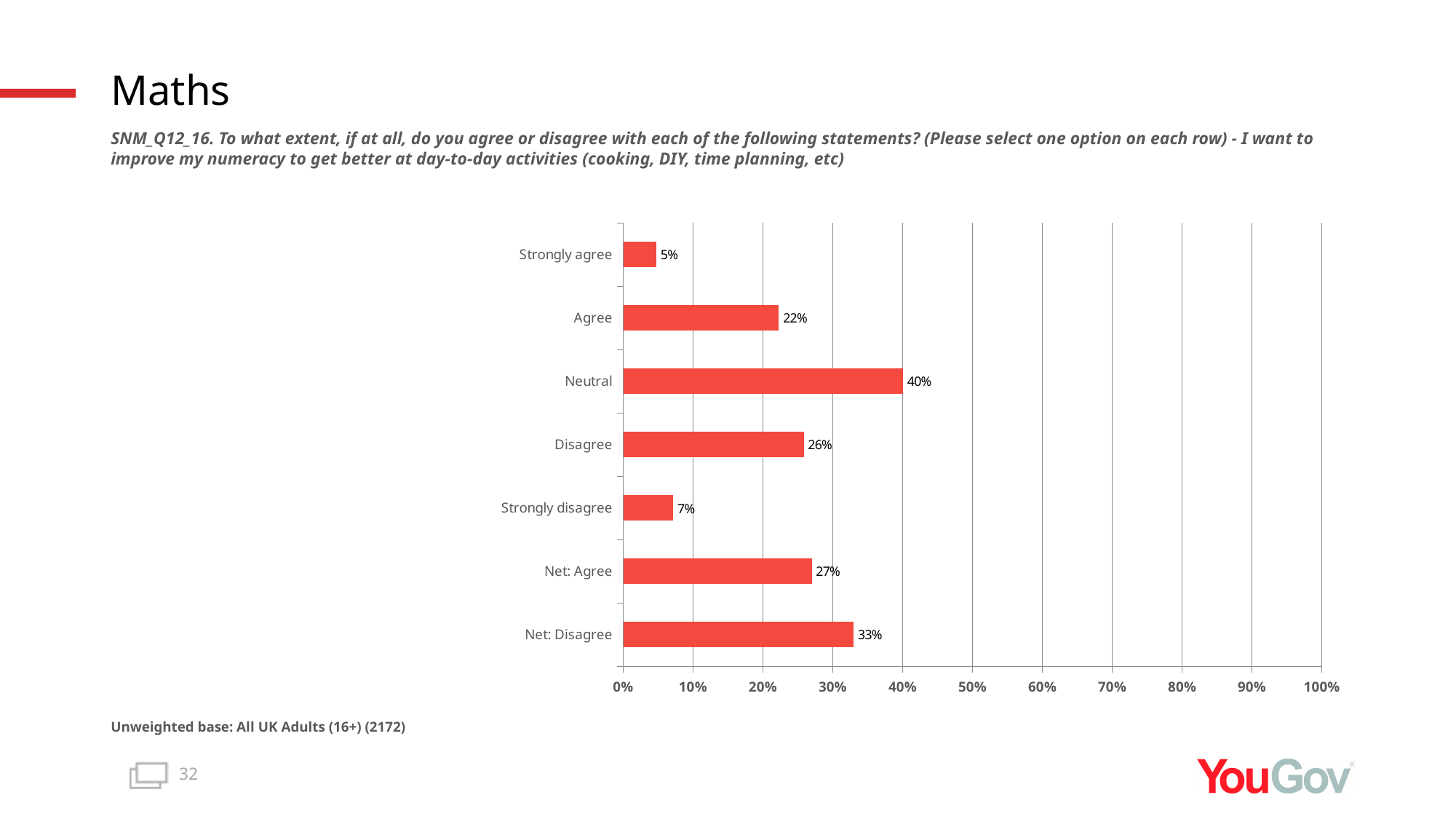
Which is larger, Agree or Disagree? Disagree What is the difference between Disagree and Agree? 4% What is the value for Net: Disagree? 33% What is the value for Strongly disagree? 7% What kind of chart is shown on the slide? Bar chart Which category has the lowest value? Strongly agree What is the value for Neutral? 40% What is the value for Strongly agree? 5% Is the value for Neutral greater or less than 30%? greater Which category has the highest value? Neutral How many categories are shown on the chart? 7 What is the difference between Net: Disagree and Net: Agree? 6%